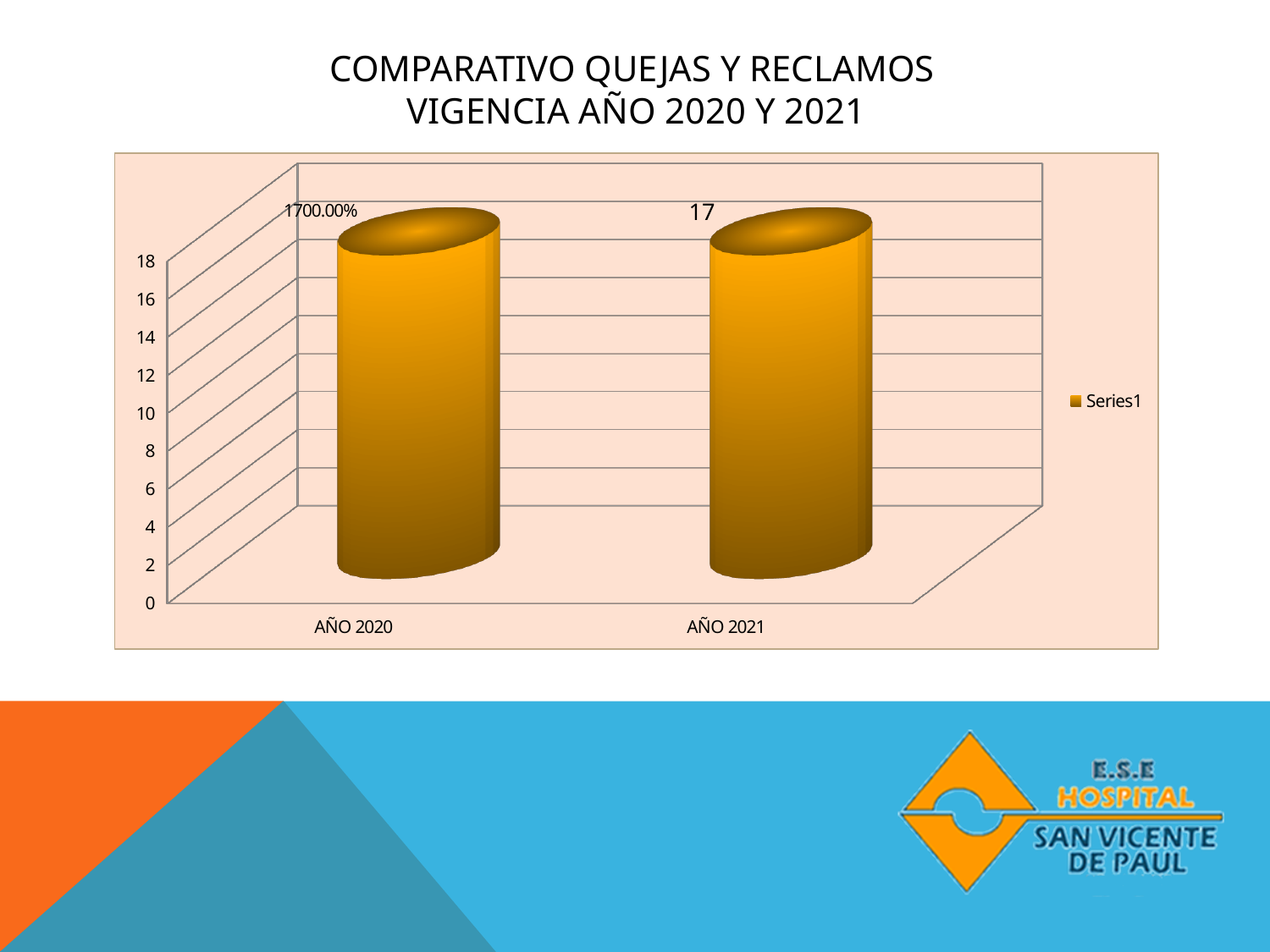
What is the value shown for AÑO 2021? 17 How many categories are shown on the x axis of the chart? 2 Is the value for AÑO 2021 greater or less than 10? greater How many series does the legend list? 1 What is the title of the chart on the slide? COMPARATIVO QUEJAS Y RECLAMOS VIGENCIA AÑO 2020 Y 2021 What data label is shown on the bar for AÑO 2020? 1700.00% What is the name of the series listed in the legend? Series1 What is the highest value shown on the y axis of the chart? 18 What kind of chart is shown on the slide? bar chart Is the value for AÑO 2020 greater or less than 12? greater